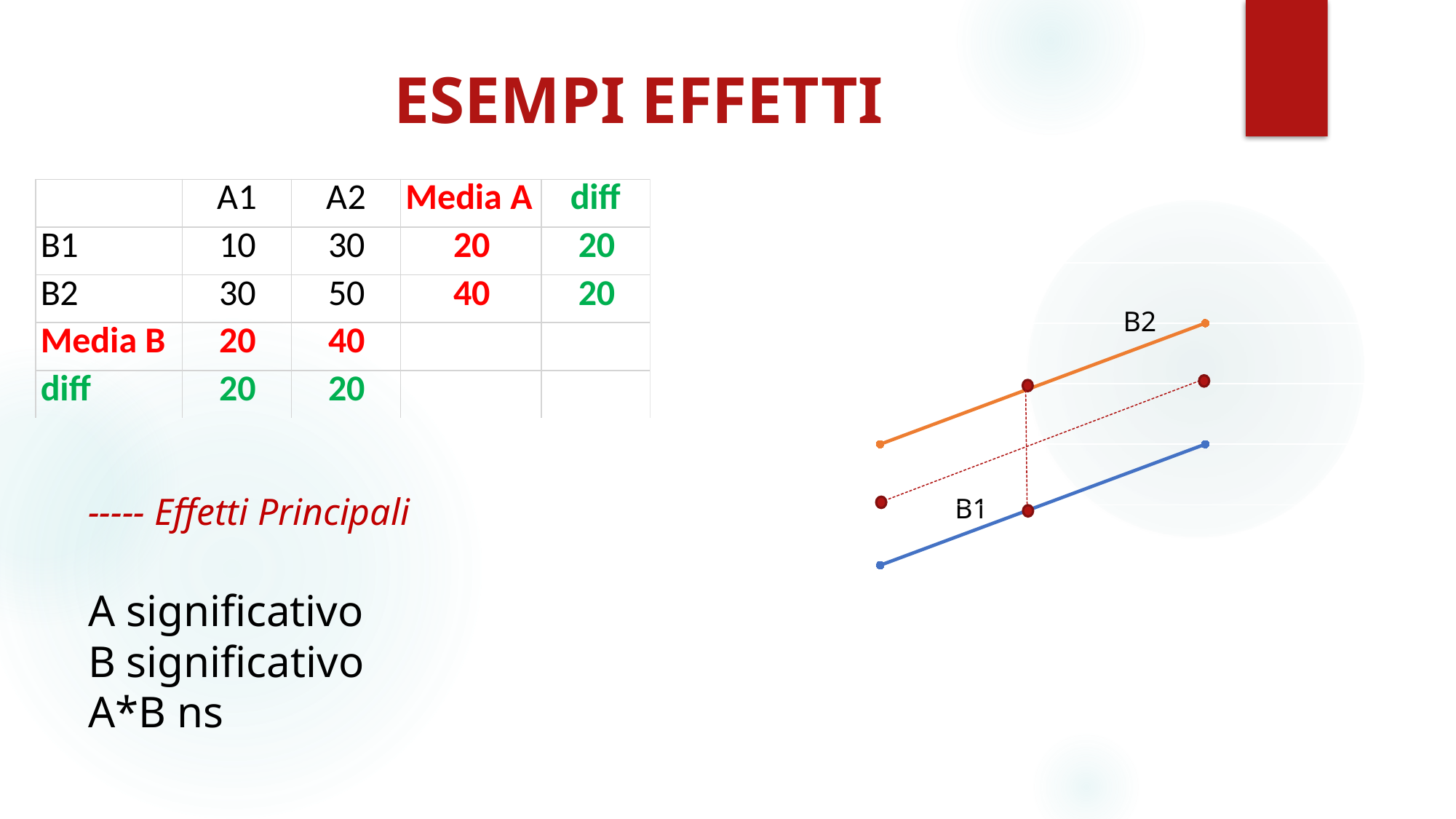
What are the labels of the two lines in the chart? B1 and B2 Which line is positioned lower in the chart, B1 or B2? B1 Are the B1 and B2 lines parallel or do they cross? parallel How many lines are plotted in the chart? 2 Which line is positioned higher in the chart, B1 or B2? B2 Does the B2 line rise or fall from left to right? rises What kind of chart is shown on the right of the slide? line chart How many endpoints does each solid line in the chart have? 2 Does the B1 line rise or fall from left to right? rises What colour is the B2 line? orange